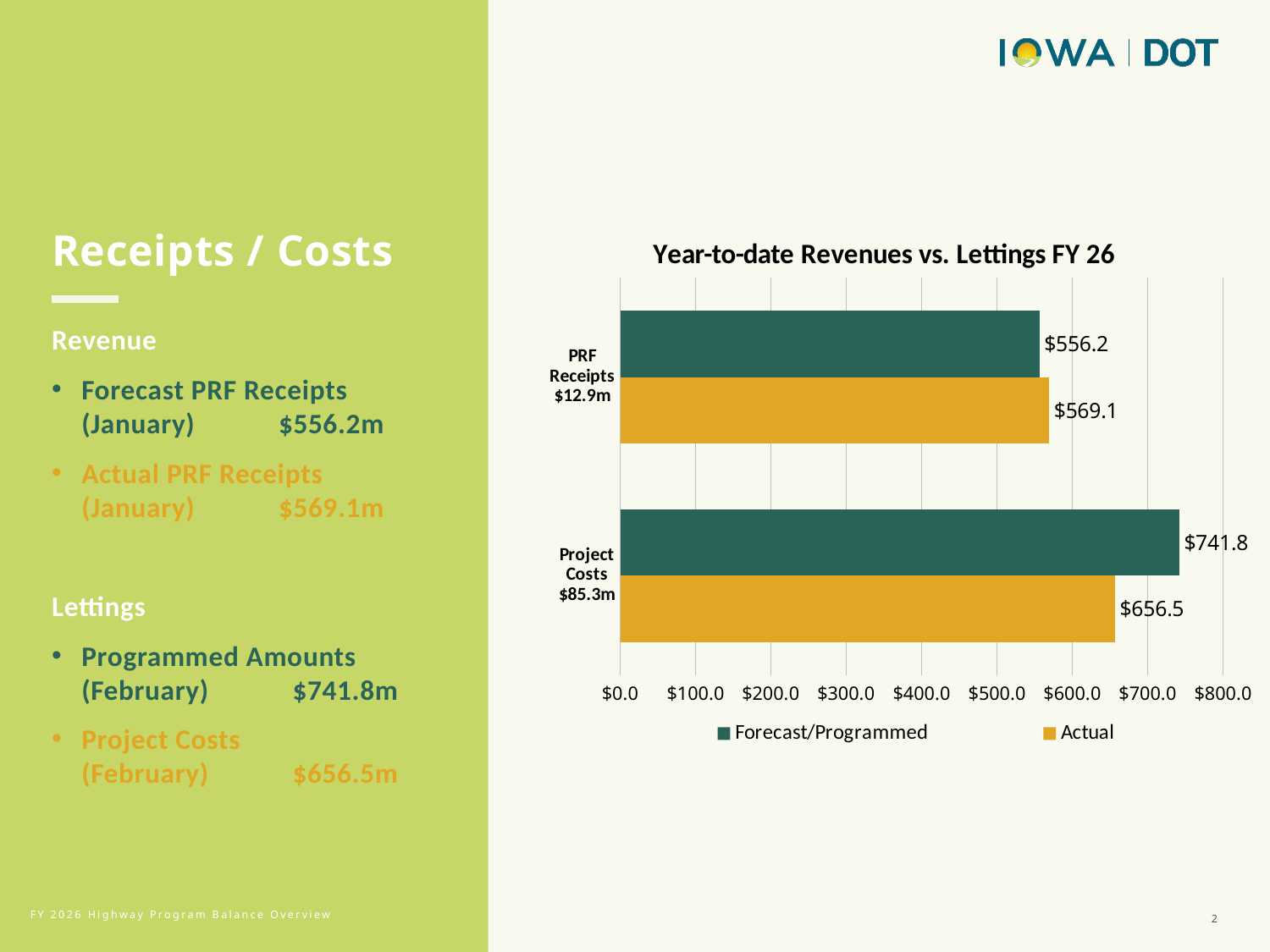
What type of chart is shown on the slide? Bar chart What is the difference between the Actual and Forecast/Programmed values for PRF Receipts? $12.9 How many series does the chart legend list? 2 What is the Actual value for Project Costs? $656.5 What is the title of the chart? Year-to-date Revenues vs. Lettings FY 26 Which bar in the chart has the lowest value? PRF Receipts, Forecast/Programmed What is the Actual value for PRF Receipts? $569.1 Which bar in the chart has the highest value? Project Costs, Forecast/Programmed What is the Forecast/Programmed value for Project Costs? $741.8 What is the difference between the Forecast/Programmed and Actual values for Project Costs? $85.3 For PRF Receipts, which is larger: the Forecast/Programmed value or the Actual value? Actual What is the Forecast/Programmed value for PRF Receipts? $556.2